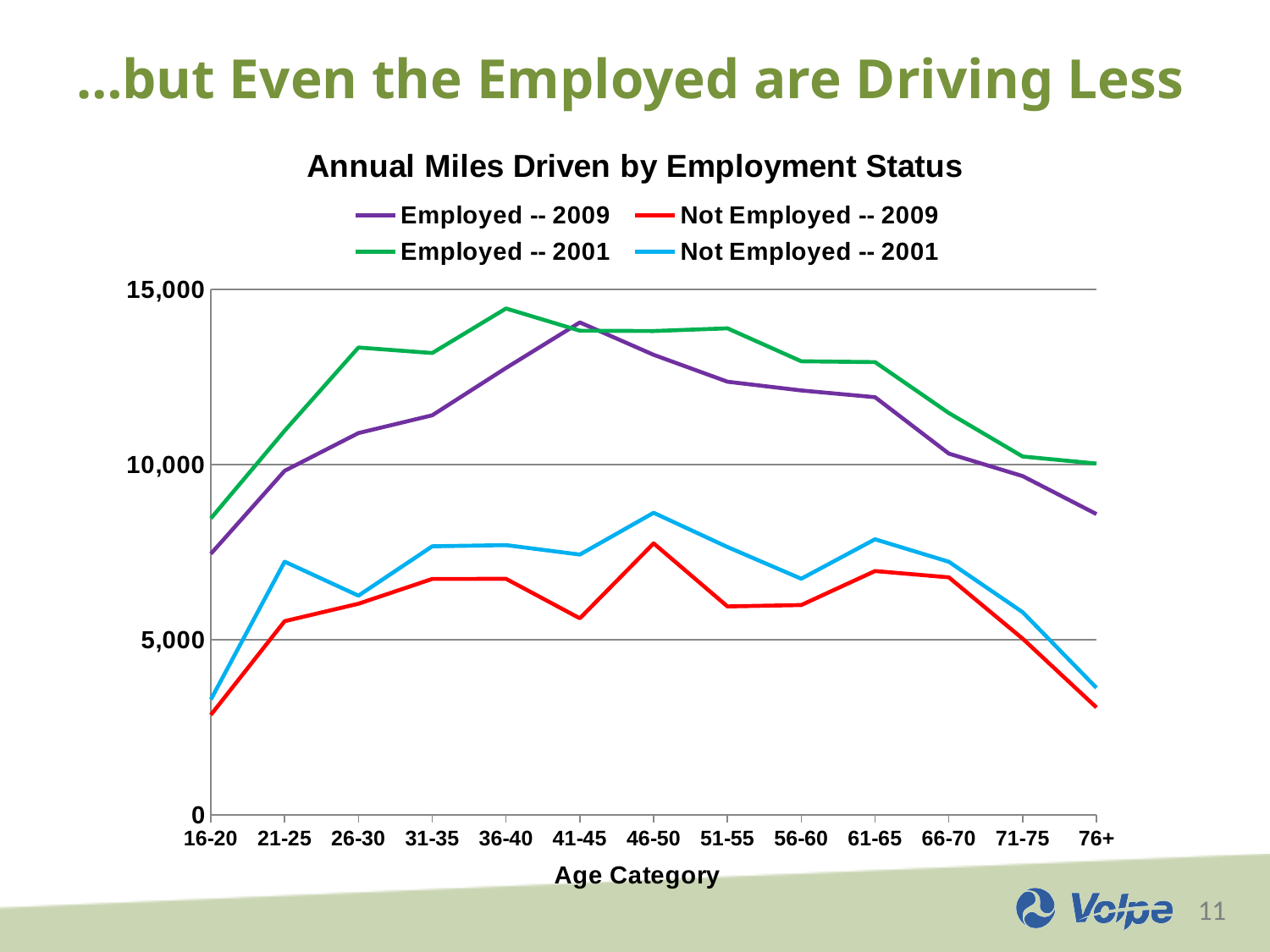
Is the value for Employed -- 2001 at age 16-20 greater or less than 10,000? less What is the title of the chart? Annual Miles Driven by Employment Status What kind of chart is shown on the slide? Line chart In which age category does the Employed -- 2001 series reach its highest value? 36-40 In which age category is the Employed -- 2009 series at its lowest value? 16-20 Is the value for Not Employed -- 2009 at age 16-20 greater or less than 5,000? less How many series does the legend list? 4 What is the label of the x axis? Age Category In which age category does the Not Employed -- 2009 series reach its highest value? 46-50 How many age categories are shown on the x axis? 13 In which age category does the Employed -- 2009 series reach its highest value? 41-45 At age 36-40, which is larger: Employed -- 2001 or Employed -- 2009? Employed -- 2001